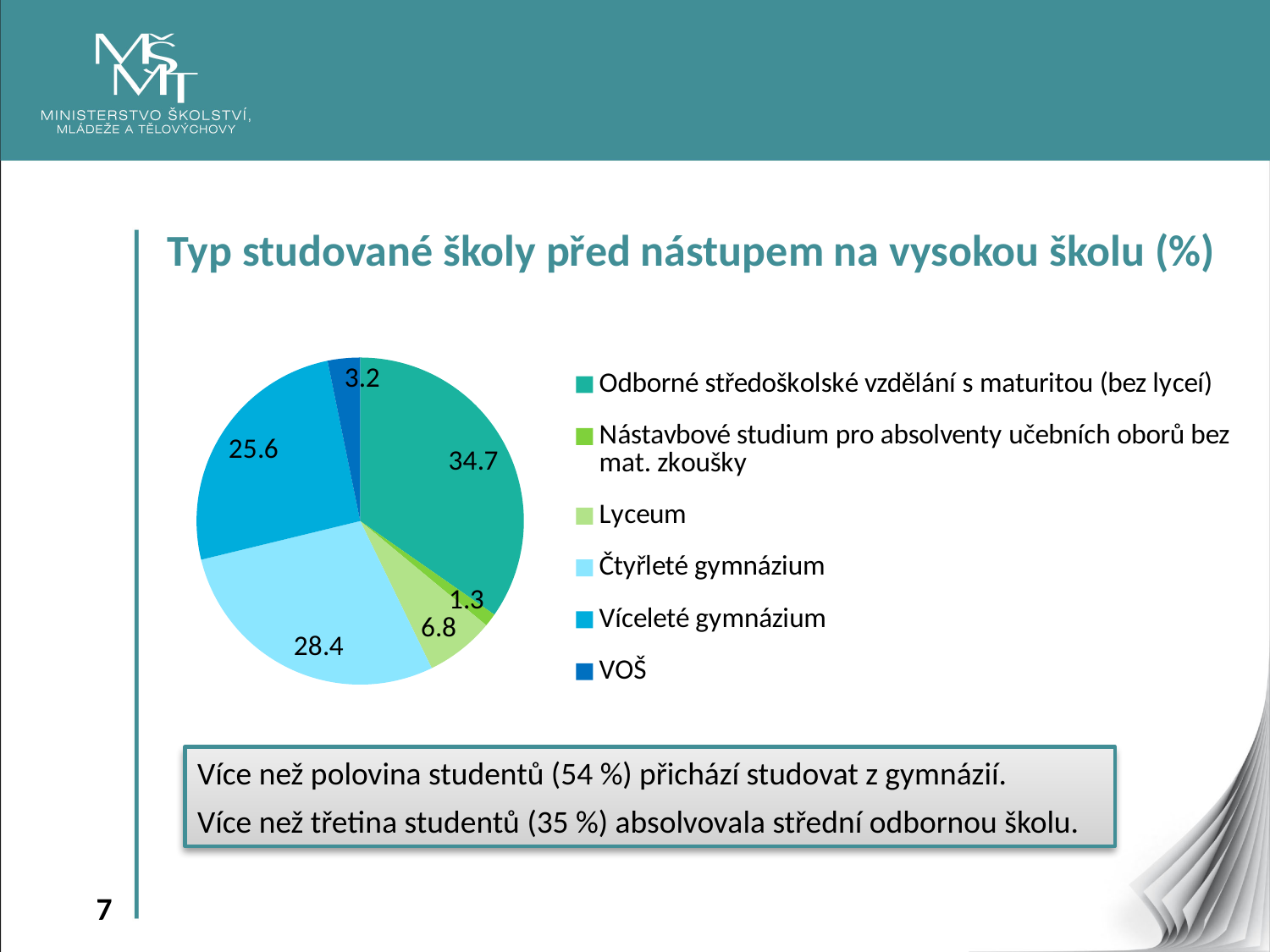
How many categories does the pie chart show? 6 What is the difference between the values for Čtyřleté gymnázium and Víceleté gymnázium? 2.8 What is the title of the chart? Typ studované školy před nástupem na vysokou školu (%) Which is larger, the value for Lyceum or the value for VOŠ? Lyceum What is the value for VOŠ? 3.2 Which category has the largest slice of the pie? Odborné středoškolské vzdělání s maturitou (bez lyceí) What is the value for Víceleté gymnázium? 25.6 What is the value for Odborné středoškolské vzdělání s maturitou (bez lyceí)? 34.7 What type of chart is shown on the slide? pie chart What is the value for Čtyřleté gymnázium? 28.4 What is the value for Lyceum? 6.8 Which category has the smallest slice of the pie? Nástavbové studium pro absolventy učebních oborů bez mat. zkoušky